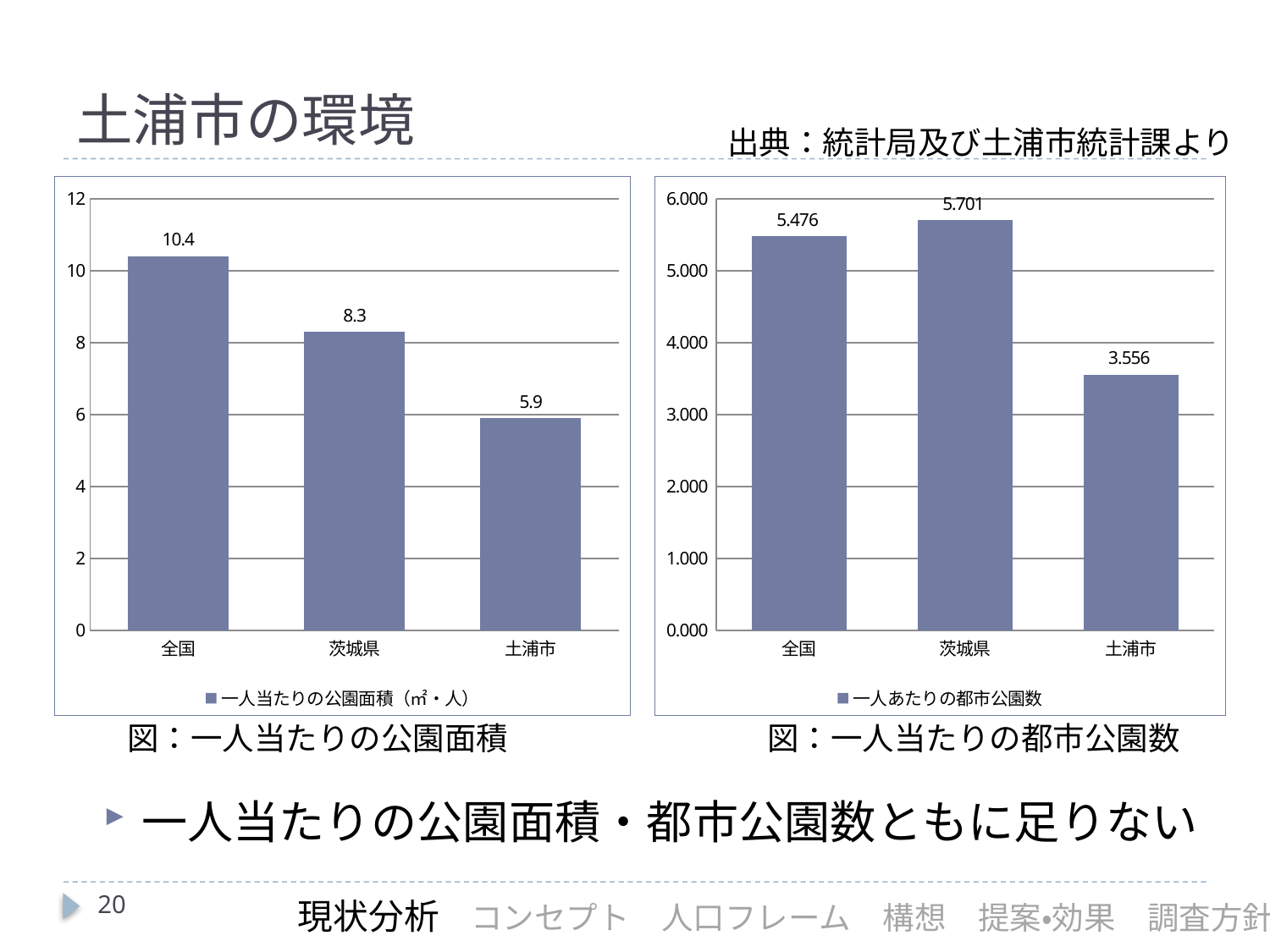
In the right chart (一人当たりの都市公園数), what is the legend entry? 一人あたりの都市公園数 In the left chart (一人当たりの公園面積), how many categories are shown? 3 In the right chart (一人当たりの都市公園数), what is the value for 土浦市? 3.556 In the left chart (一人当たりの公園面積), which category has the lowest value? 土浦市 In the left chart (一人当たりの公園面積), what is the difference between 全国 and 茨城県? 2.1 In the left chart (一人当たりの公園面積), what is the value for 土浦市? 5.9 In the left chart (一人当たりの公園面積), what is the value for 全国? 10.4 In the right chart (一人当たりの都市公園数), what is the difference between 全国 and 土浦市? 1.920 In the left chart (一人当たりの公園面積), do the values rise or fall from left to right? fall In the right chart (一人当たりの都市公園数), what is the value for 茨城県? 5.701 In the right chart (一人当たりの都市公園数), what kind of chart is it? bar chart In the right chart (一人当たりの都市公園数), which category has the highest value? 茨城県